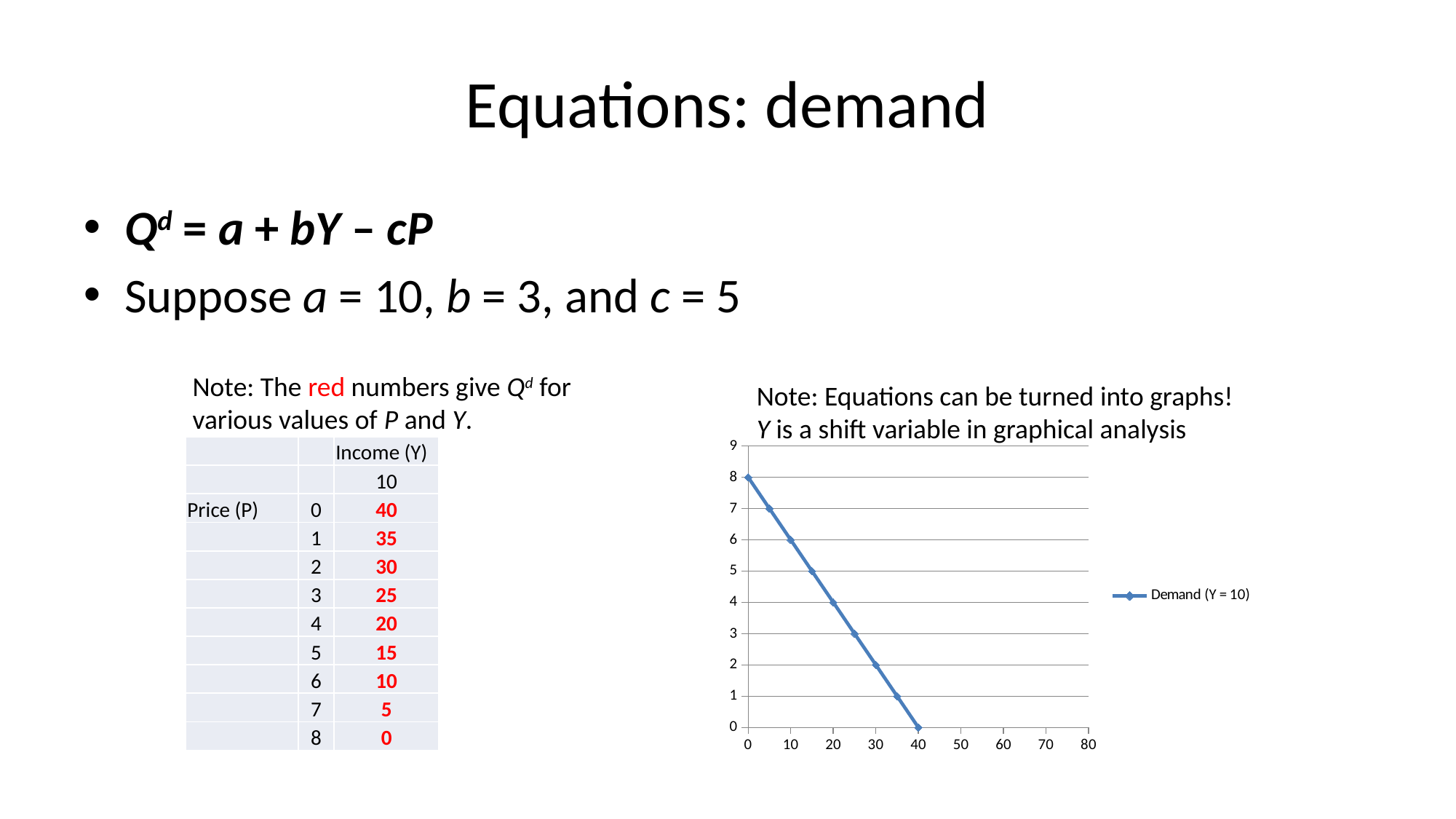
As the x-axis value increases, does the demand line rise or fall? fall Is the x-axis value of the point at vertical-axis value 1 greater or less than 30? greater How many data points are plotted on the demand line? 9 What is the highest value shown on the chart's x axis? 80 How many series does the chart's legend list? 1 What kind of chart is shown on the slide? line chart What is the x-axis value of the point on the demand line at a vertical-axis value of 6? 10 Is the x-axis value of the point at vertical-axis value 5 greater or less than 20? less What is the x-axis value of the point where the demand line reaches 0 on the vertical axis? 40 What is the name of the series shown in the chart's legend? Demand (Y = 10) What is the vertical-axis value of the demand line at x = 0? 8 What is the vertical-axis value of the demand line at x = 20? 4